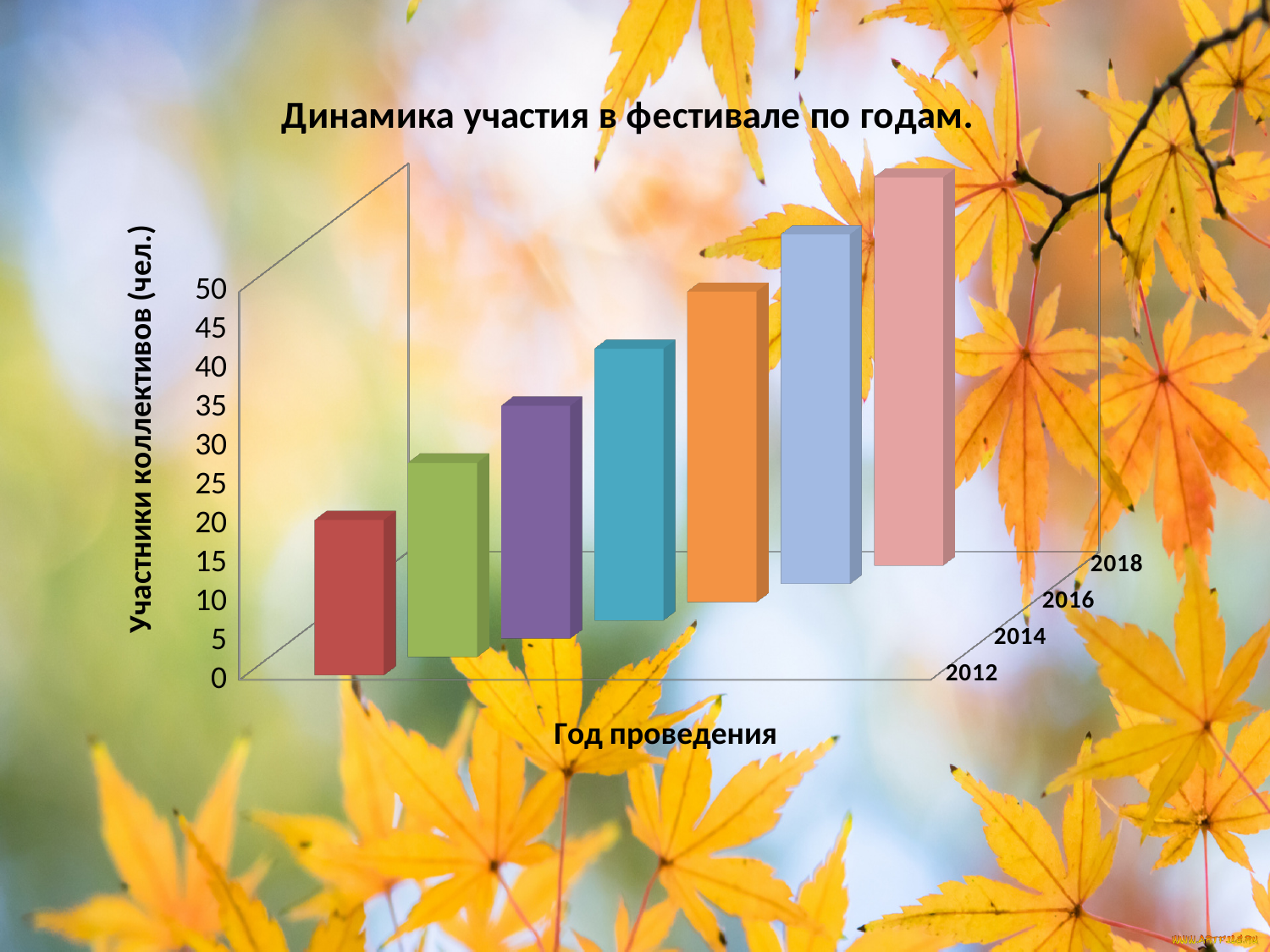
Which is larger, the value for 2014 or the value for 2016? 2016 Is the value for 2018 greater or less than 40? greater Which year has the highest bar? 2018 Which year has the lowest bar? 2012 What type of chart is shown on the slide? bar chart Is the value for 2016 greater or less than 30? greater Is the value for 2012 greater or less than 30? less What is the label of the vertical axis? Участники коллективов (чел.) How many bars are plotted in the chart? 7 Which is larger, the value for 2012 or the value for 2018? 2018 Do the values rise or fall from 2012 to 2018? rise What is the title of the chart? Динамика участия в фестивале по годам.